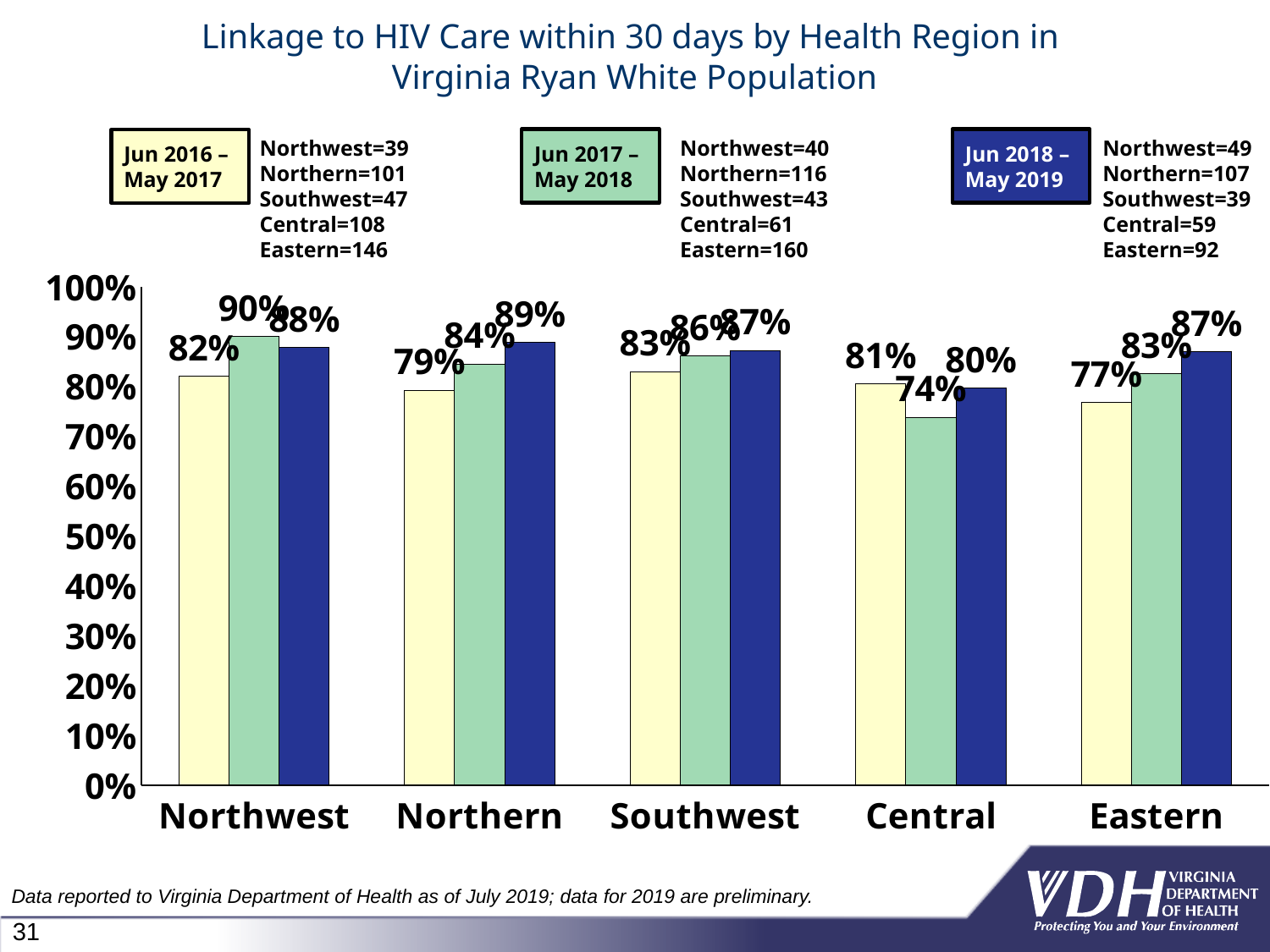
What is the linkage to care percentage for Eastern in Jun 2018 – May 2019? 87% Which is larger for Central: the Jun 2016 – May 2017 value or the Jun 2018 – May 2019 value? Jun 2016 – May 2017 What type of chart is shown on the slide? bar chart Which region has the lowest value in the Jun 2016 – May 2017 period? Eastern According to the legend, how many people were in the Eastern region in Jun 2017 – May 2018? 160 What is the difference between the Jun 2018 – May 2019 and Jun 2016 – May 2017 values for Northern? 10% Do the values for Eastern rise or fall across the three periods from Jun 2016 – May 2017 to Jun 2018 – May 2019? rise What is the linkage to care percentage for Central in Jun 2017 – May 2018? 74% How many health regions are shown on the x axis? 5 How many time periods (series) does the legend list? 3 Which region has the highest value in the Jun 2017 – May 2018 period? Northwest What is the linkage to care percentage for Northwest in Jun 2016 – May 2017? 82%